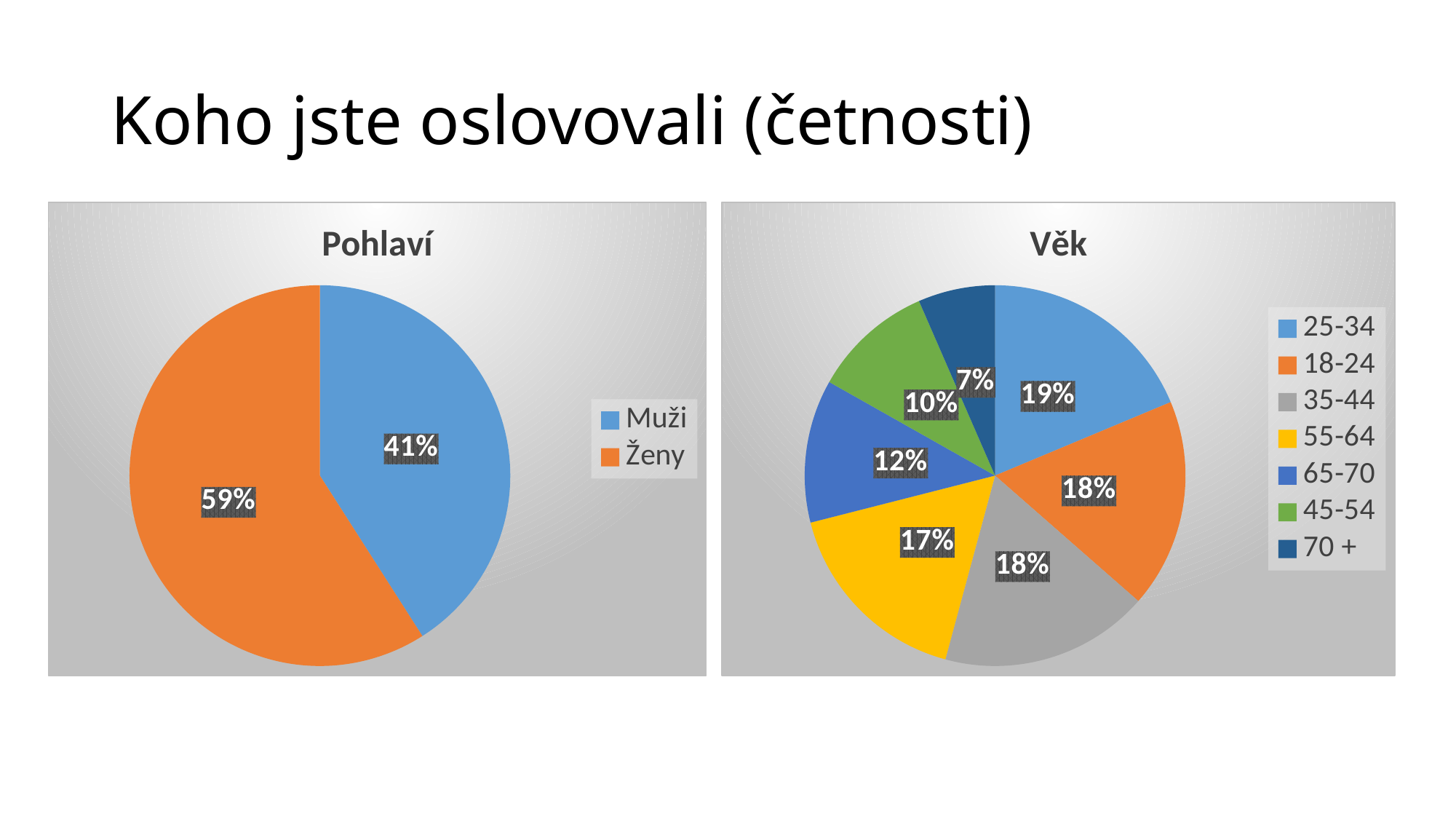
How many age groups does the legend of the "Věk" chart list? 7 In the "Věk" chart, what share of the pie is the 55-64 group? 17% What kind of chart is the "Věk" chart? Pie chart In the "Věk" chart, which age group has the smallest share? 70 + In the "Pohlaví" chart, what is the difference between the Ženy and Muži shares? 18% In the "Věk" chart, which colour represents the 55-64 group? Yellow In the "Věk" chart, which age group has the largest share? 25-34 In the "Věk" chart, what is the difference between the 65-70 share and the 45-54 share? 2% In the "Pohlaví" chart, which category is larger, Muži or Ženy? Ženy In the "Věk" chart, what share of the pie is the 25-34 group? 19% In the "Pohlaví" chart, what share of the pie is Muži? 41%